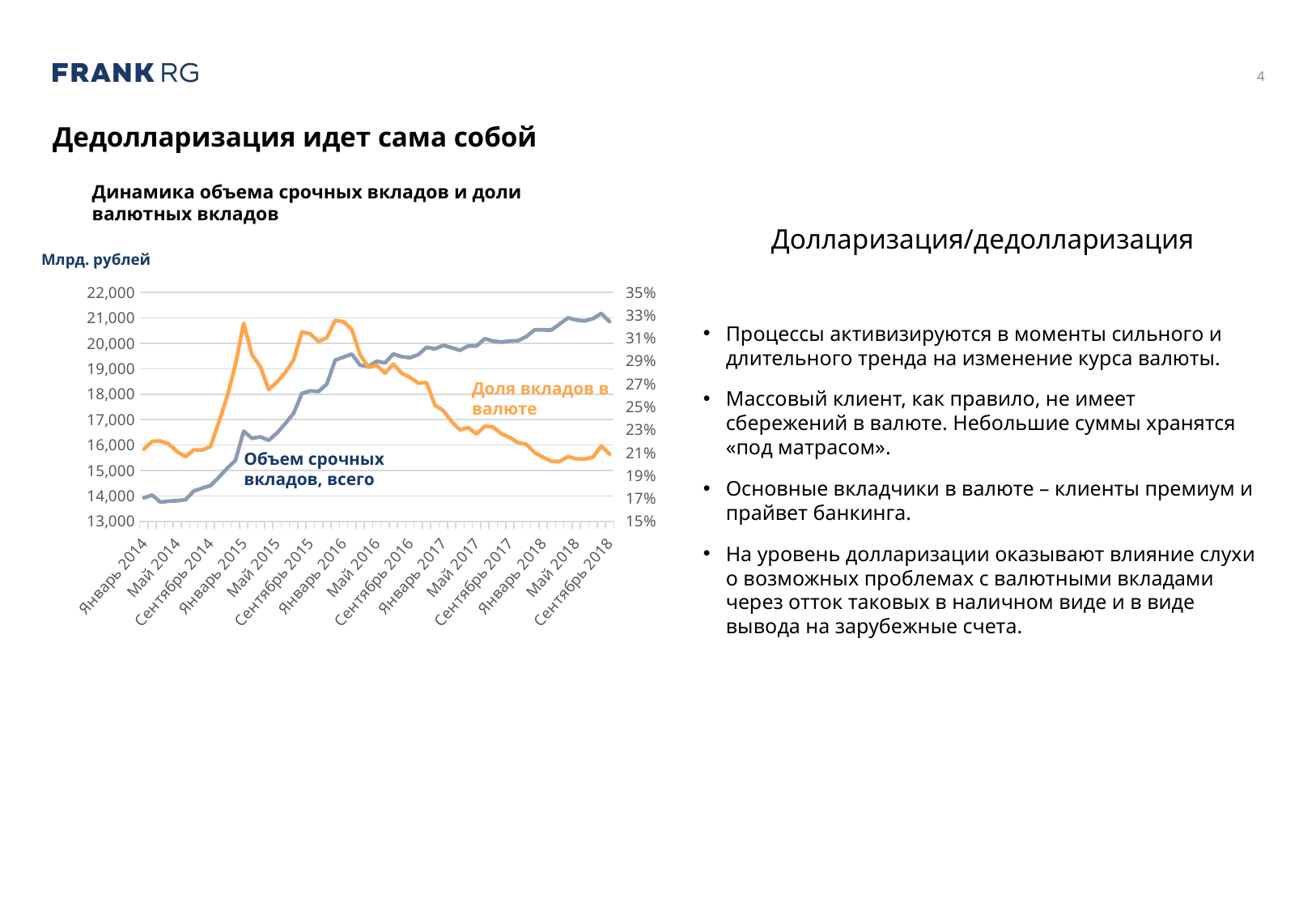
What is the title of the chart? Динамика объема срочных вкладов и доли валютных вкладов Is the value of 'Объем срочных вкладов, всего' in Январь 2014 greater or less than 15,000? less How many data series are plotted on the chart? 2 What kind of chart is shown on the slide? Line chart Which is larger for 'Доля вкладов в валюте': the value in Январь 2016 or the value in Сентябрь 2018? Январь 2016 Is the value of 'Доля вкладов в валюте' in Январь 2016 greater or less than 29%? greater What unit is shown for the left vertical axis of the chart? Млрд. рублей Does the series 'Доля вкладов в валюте' rise or fall from Январь 2016 to Сентябрь 2018? Fall Does the series 'Объем срочных вкладов, всего' generally rise or fall from Январь 2014 to Сентябрь 2018? Rise Is the value of 'Объем срочных вкладов, всего' in Сентябрь 2018 greater or less than 20,000? greater Which is larger for 'Объем срочных вкладов, всего': the value in Январь 2014 or the value in Сентябрь 2018? Сентябрь 2018